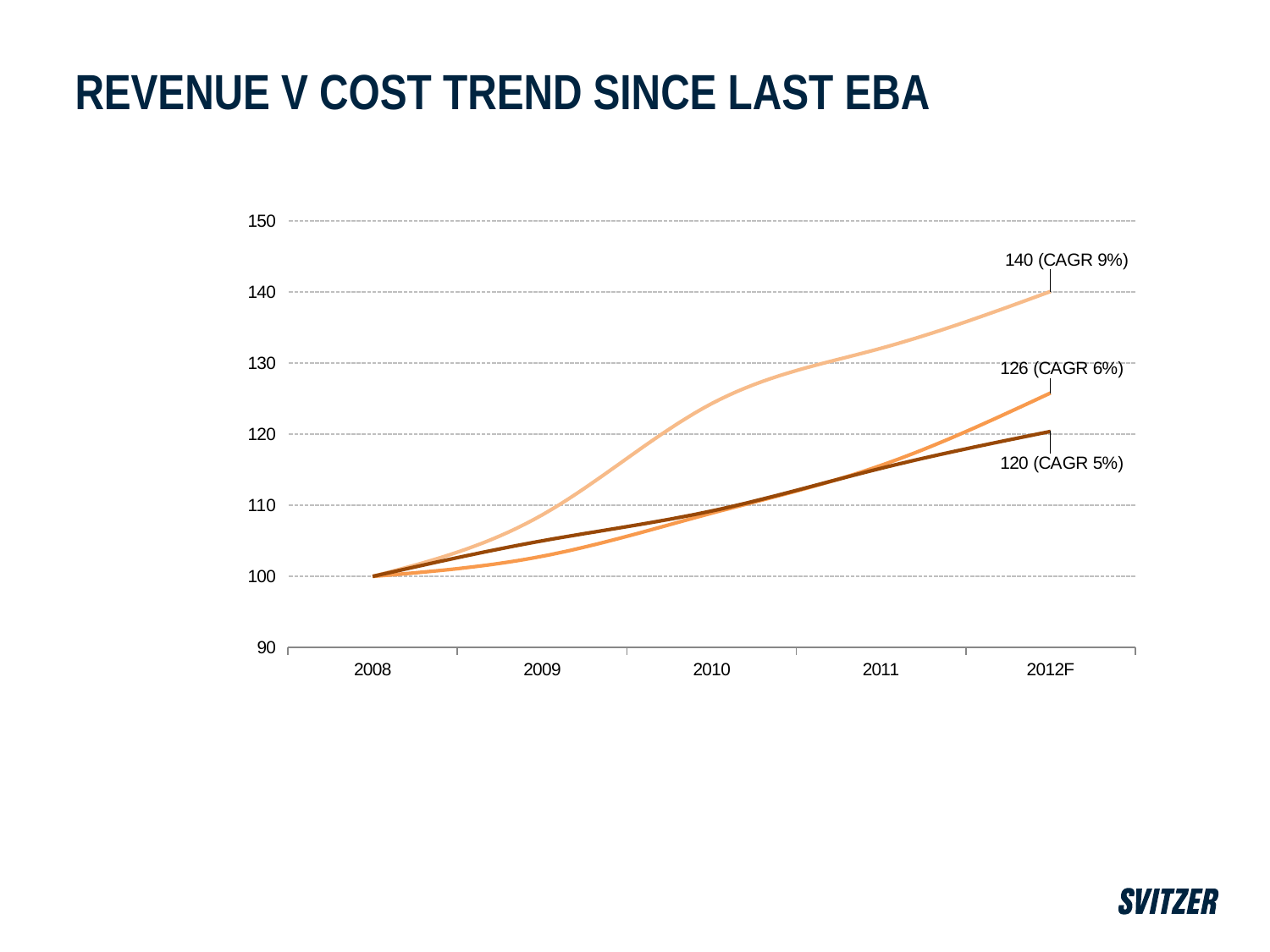
What CAGR is shown for the line that ends at 126? 6% What is the lowest end value labelled on the chart at 2012F? 120 Is the value of the lightest orange line in 2011 greater or less than 120? greater Do the lines rise or fall from 2008 to 2012F? rise At what value do all three lines start in 2008? 100 How many years are labelled on the x axis of the chart? 5 What is the title of the chart slide? REVENUE V COST TREND SINCE LAST EBA What is the highest end value labelled on the chart at 2012F? 140 What CAGR is shown for the line that ends at 140? 9% What CAGR is shown for the line that ends at 120? 5% What is the difference between the highest and lowest end values labelled at 2012F? 20 What kind of chart is shown on the slide? line chart